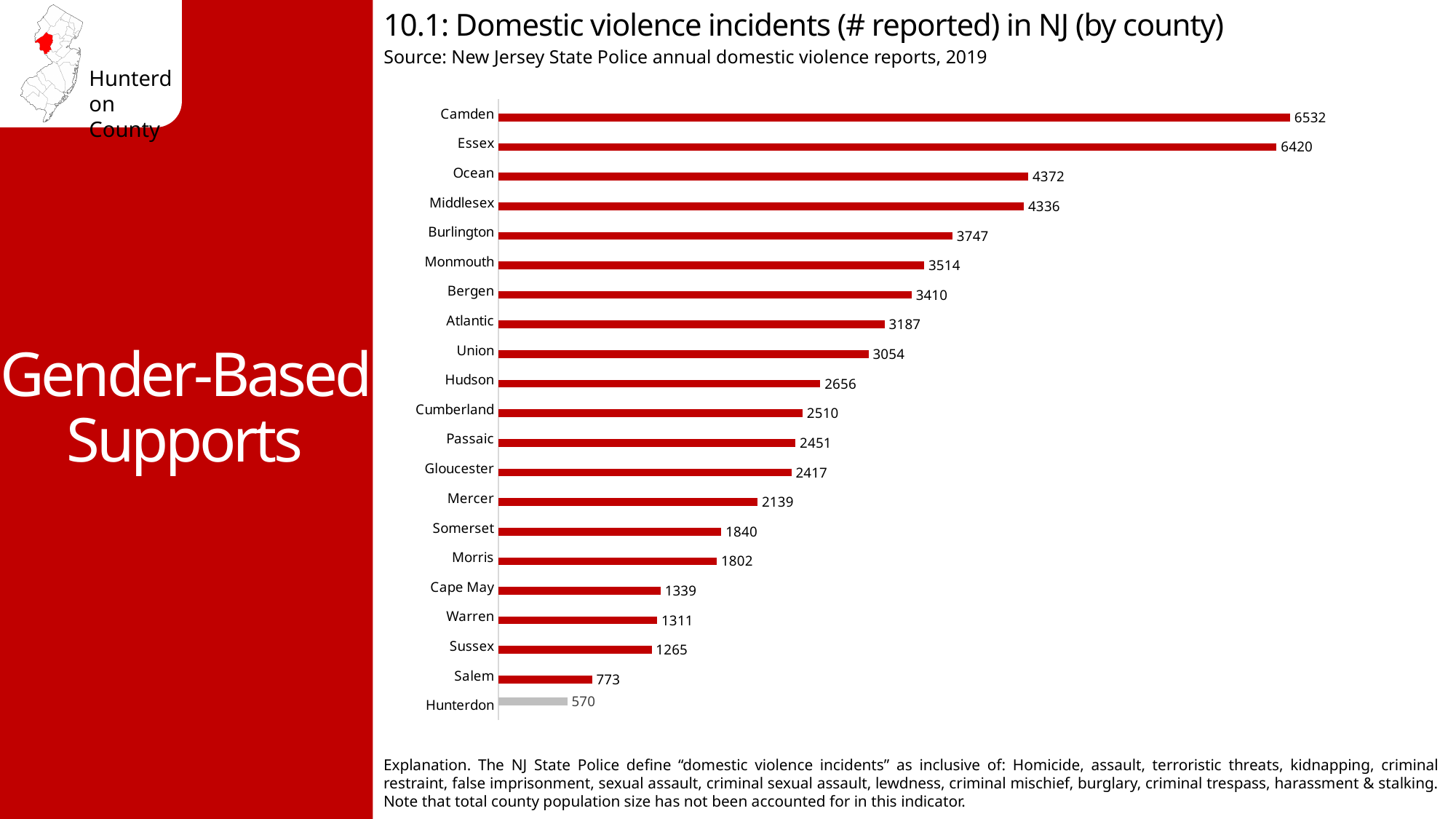
Which county reported more incidents, Somerset or Cape May? Somerset How many incidents were reported in Bergen County? 3410 Which county has the lowest number of reported domestic violence incidents? Hunterdon What is the number of reported domestic violence incidents for Hunterdon County? 570 How many domestic violence incidents were reported in Camden County? 6532 Which county has the highest number of reported domestic violence incidents? Camden Which county reported more domestic violence incidents, Ocean or Burlington? Ocean How many counties are shown in the chart? 21 Which county's bar is shown in gray rather than red? Hunterdon What is the difference between the reported incidents in Camden and Essex counties? 112 How many more incidents were reported in Salem County than in Hunterdon County? 203 What type of chart is used to display the domestic violence incidents by county? Bar chart